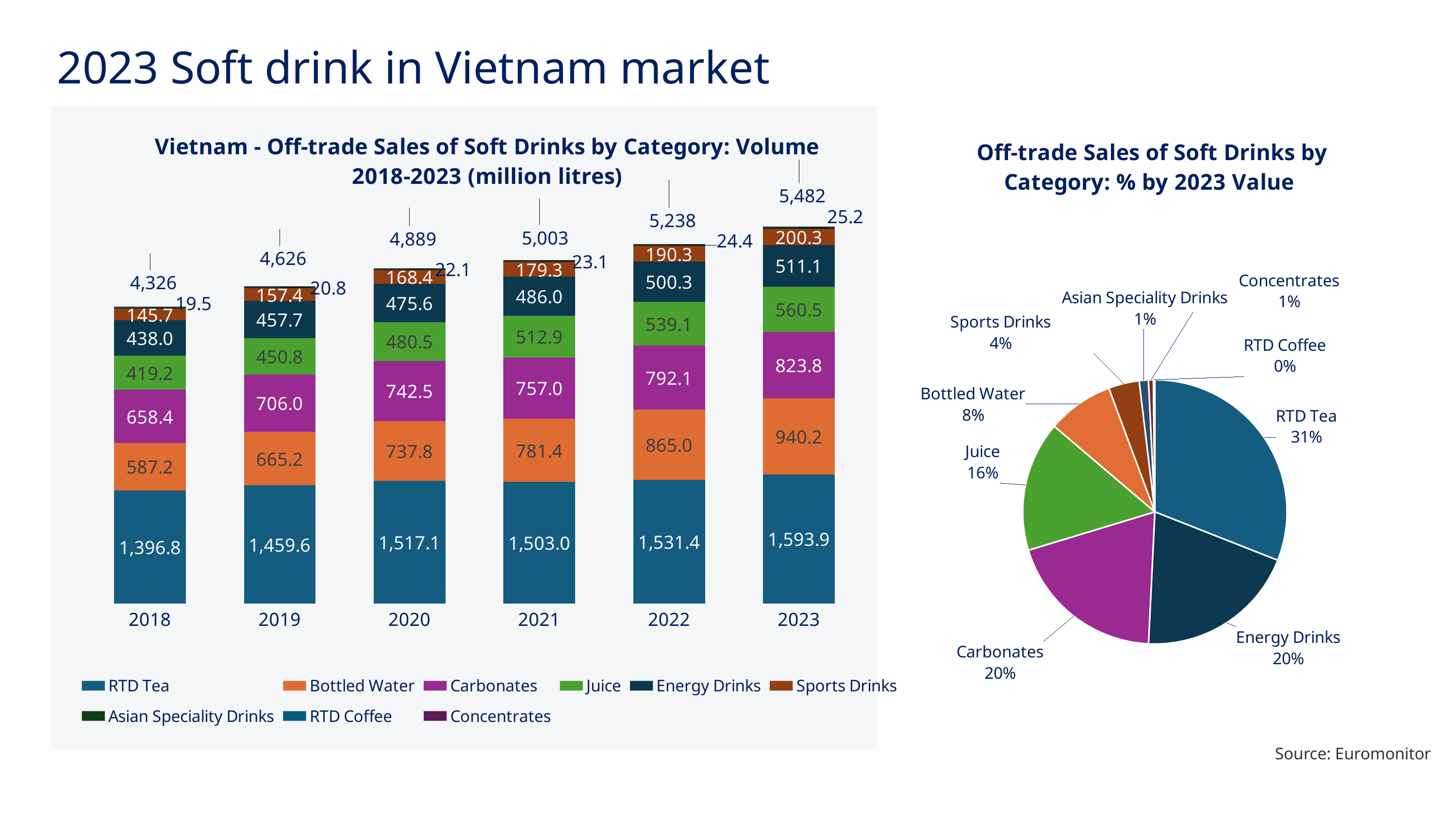
How many series does the legend of the stacked bar chart on the left list? 9 In the stacked bar chart on the left, what is the total volume shown above the 2018 bar? 4,326 How many years are shown on the x axis of the stacked bar chart on the left? 6 In the stacked bar chart on the left, what is the RTD Tea volume for 2023? 1,593.9 What kind of chart is the chart on the left of the slide? Stacked bar chart What kind of chart is the chart on the right of the slide? Pie chart In the pie chart on the right, which category has the smallest share? RTD Coffee In the stacked bar chart on the left, do the total volumes rise or fall from 2018 to 2023? Rise In the stacked bar chart on the left, which is larger in 2022: Bottled Water or Carbonates? Bottled Water In the stacked bar chart on the left, which year has the highest total volume? 2023 In the pie chart on the right, what share does RTD Tea have? 31% In the stacked bar chart on the left, what is the difference between the 2023 total (5,482) and the 2018 total (4,326)? 1,156